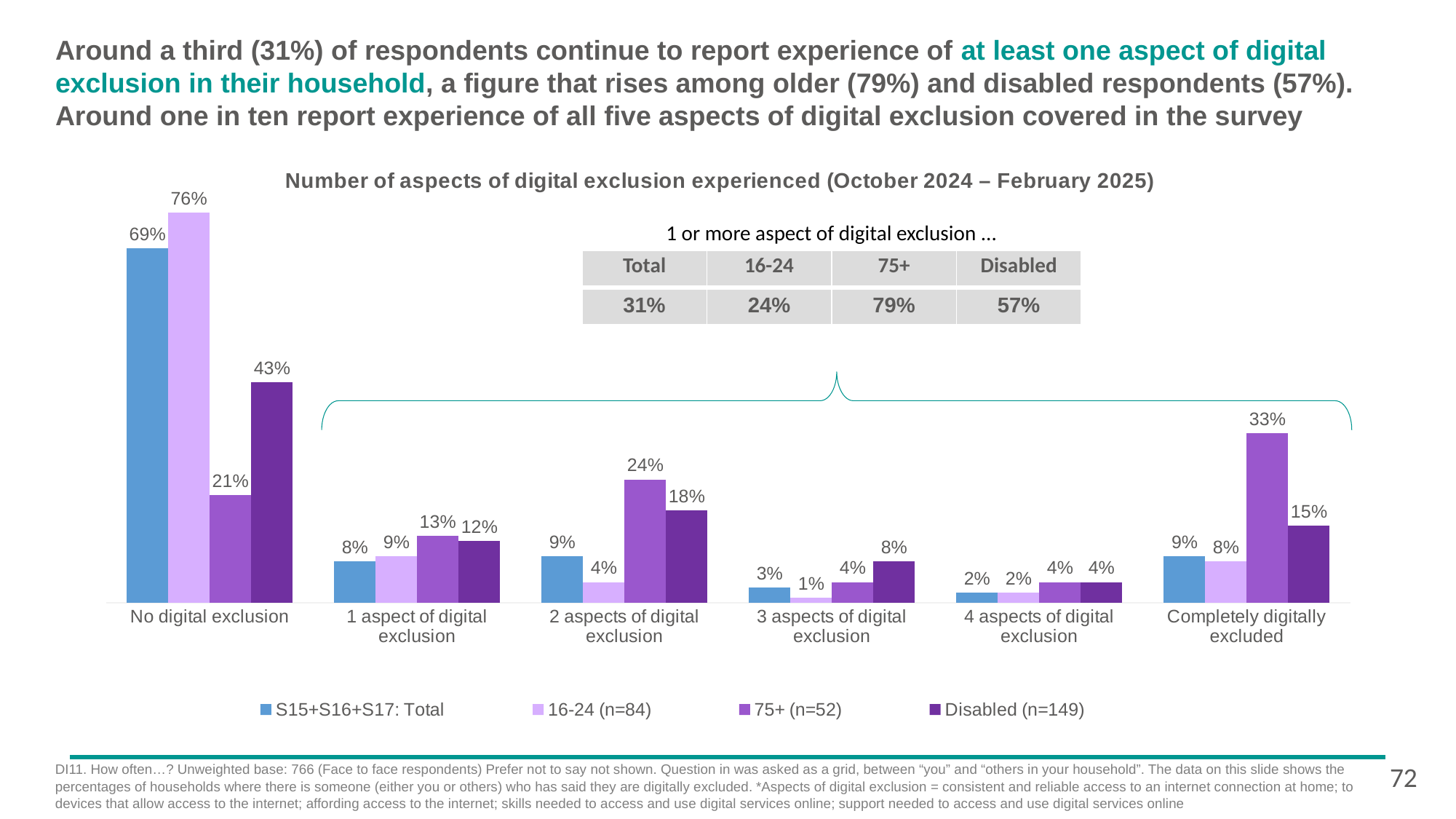
What is the title of the chart? Number of aspects of digital exclusion experienced (October 2024 – February 2025) How many categories are shown on the x axis of the chart? 6 What kind of chart is shown on the slide? Bar chart In the 'Completely digitally excluded' category, which is larger: the Disabled (n=149) value or the S15+S16+S17: Total value? Disabled (n=149) Which series has the lowest value in the 'No digital exclusion' category? 75+ (n=52) What is the value for the 75+ (n=52) series in the 'Completely digitally excluded' category? 33% Which series has the highest value in the '3 aspects of digital exclusion' category? Disabled (n=149) What is the value for the Disabled (n=149) series in the '2 aspects of digital exclusion' category? 18% What is the difference between the 75+ (n=52) and 16-24 (n=84) values in the '2 aspects of digital exclusion' category? 20 percentage points According to the table on the slide, what percentage of 75+ respondents report 1 or more aspect of digital exclusion? 79% What is the value for the 16-24 (n=84) series in the 'No digital exclusion' category? 76% How many series does the chart legend list? 4